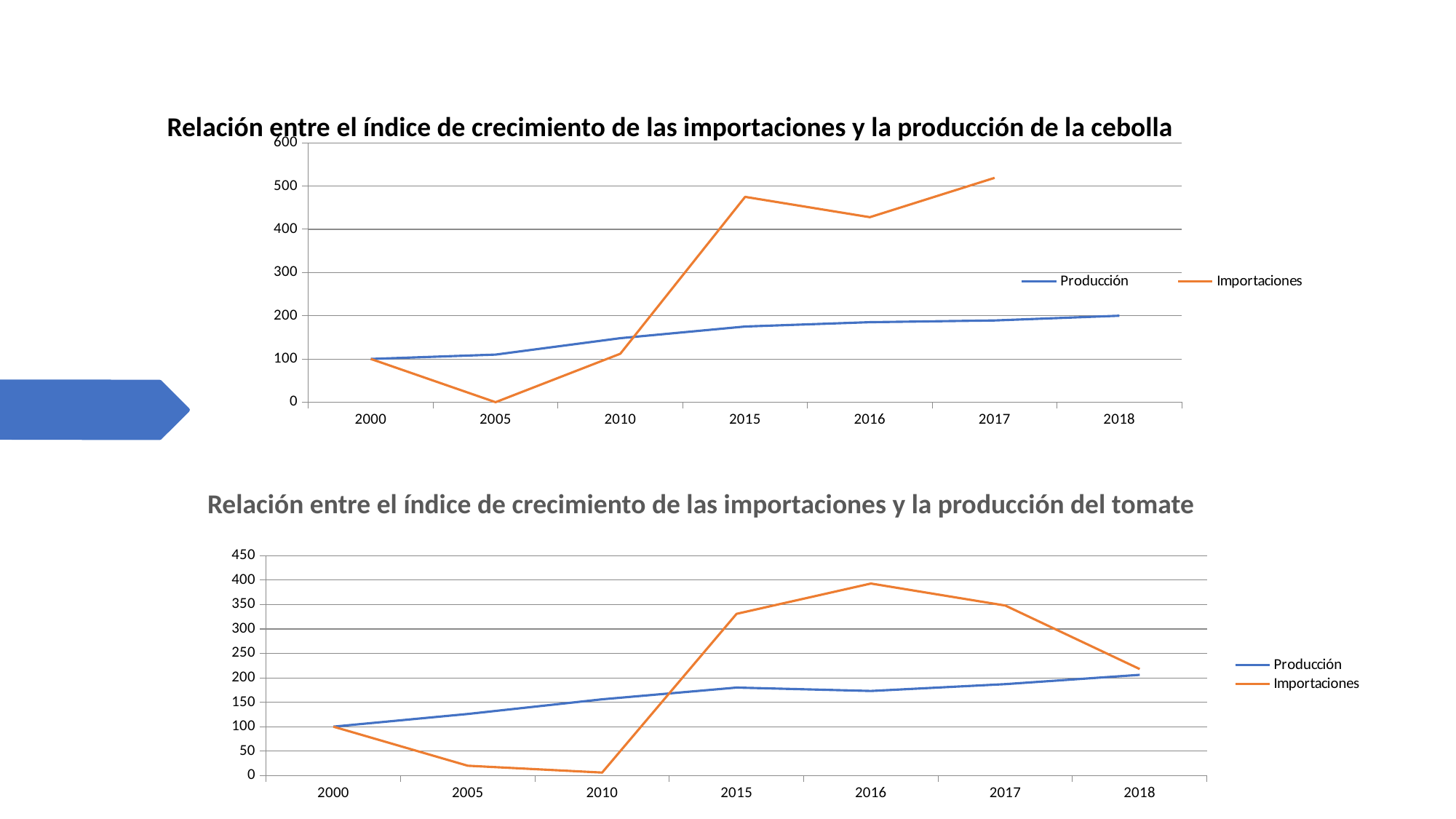
In the top chart (cebolla), what is the value of Producción in 2000? 100 In the top chart (cebolla), which series has the larger value in 2005, Producción or Importaciones? Producción In the top chart (cebolla), how many series does the legend list? 2 In the top chart (cebolla), in which year does Importaciones reach its highest value? 2017 In the top chart (cebolla), how many years are shown on the x axis? 7 In the bottom chart (tomate), in which year does Importaciones reach its lowest value? 2010 What kind of chart is the top chart, 'Relación entre el índice de crecimiento de las importaciones y la producción de la cebolla'? line chart In the bottom chart (tomate), does the Producción line generally rise or fall from 2000 to 2018? rise In the bottom chart (tomate), which series has the larger value in 2015, Producción or Importaciones? Importaciones In the bottom chart (tomate), is the value of Importaciones in 2016 greater or less than 350? greater In the bottom chart (tomate), in which year does Importaciones reach its highest value? 2016 In the top chart (cebolla), is the value of Importaciones in 2015 greater or less than 400? greater